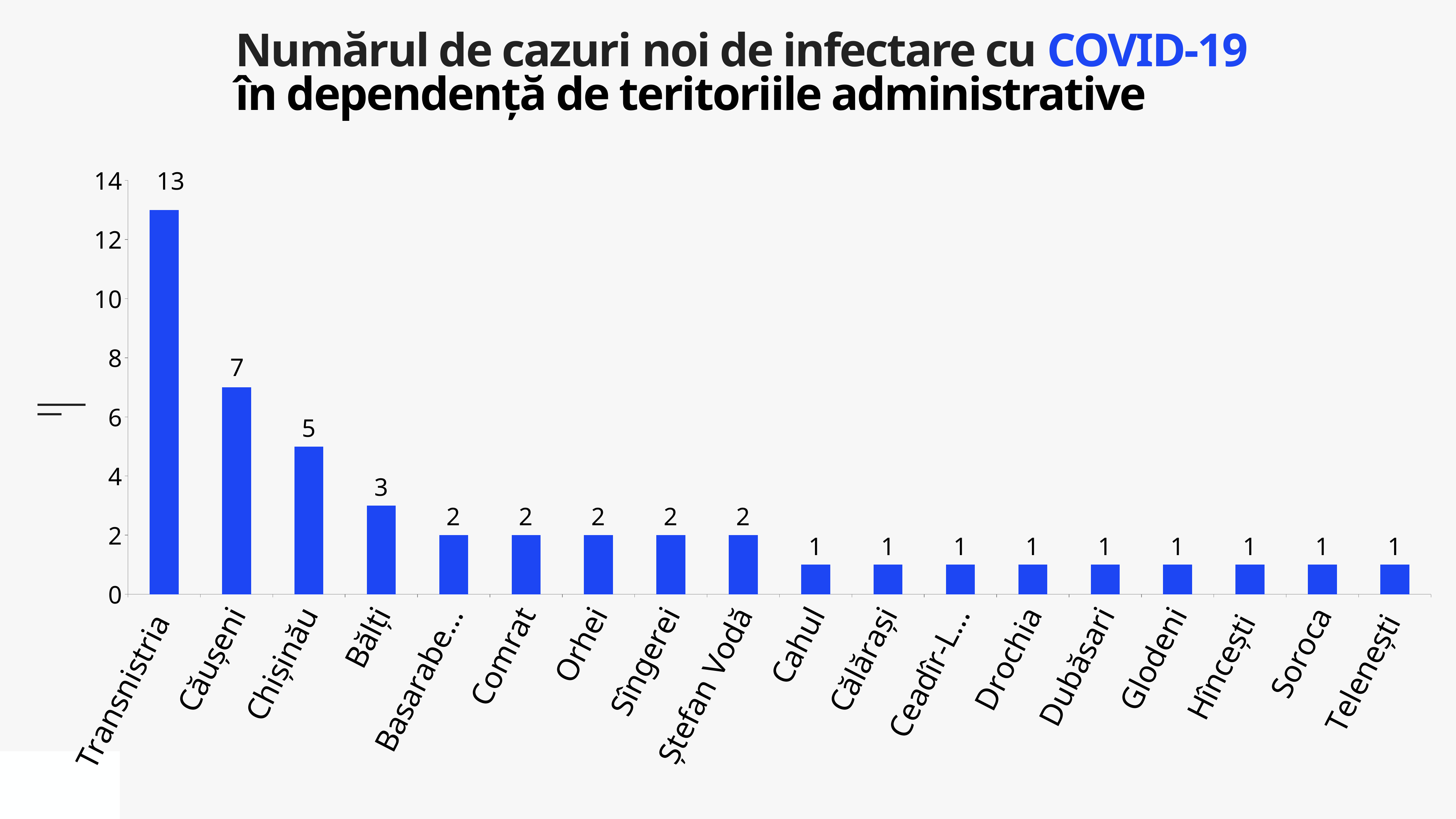
Do the values rise or fall from left to right along the x axis? Fall Which administrative territory has the highest number of new COVID-19 cases? Transnistria Which has more new cases, Chișinău or Bălți? Chișinău What is the number of new COVID-19 cases for Soroca? 1 What is the number of new COVID-19 cases for Orhei? 2 What is the number of new COVID-19 cases for Bălți? 3 What is the number of new COVID-19 cases for Chișinău? 5 What is the number of new COVID-19 cases for Căușeni? 7 What kind of chart is shown on the slide? Bar chart What is the number of new COVID-19 cases for Transnistria? 13 What is the difference between the number of new cases in Transnistria and Căușeni? 6 How many administrative territories are shown on the chart? 18